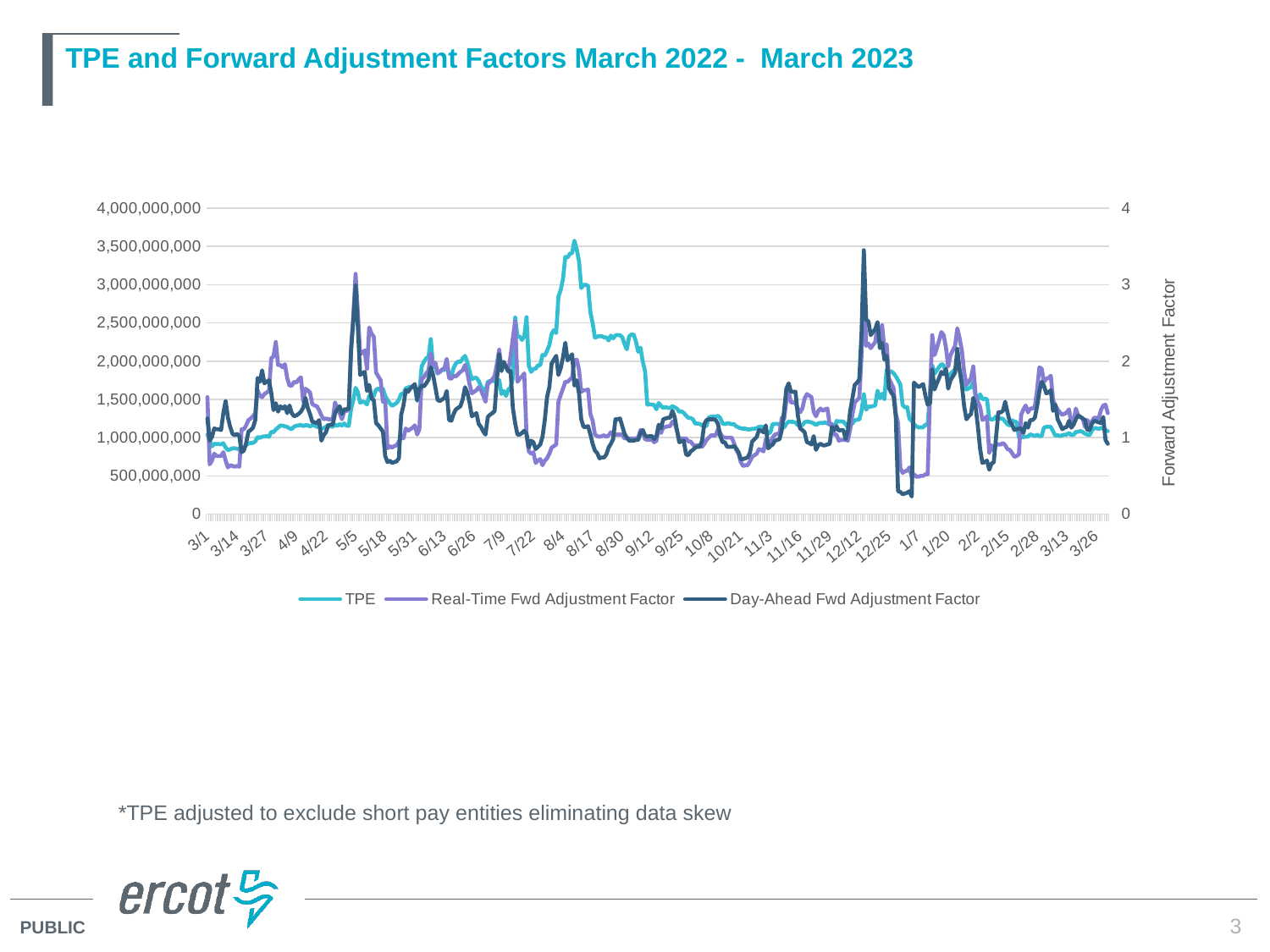
What is the label on the right-hand vertical axis? Forward Adjustment Factor Is the spike in the Day-Ahead Fwd Adjustment Factor around 12/12 greater or less than 3? greater Near which x-axis date does the Day-Ahead Fwd Adjustment Factor reach its highest value? 12/12 Does the TPE series rise or fall between 8/4 and 9/12? fall Is the TPE value around 9/25 greater or less than 1,500,000,000? less What kind of chart is shown on the slide? Line chart Near which x-axis date does the TPE series reach its highest value? 8/4 What is the title of the chart? TPE and Forward Adjustment Factors March 2022 - March 2023 Is the TPE value at 3/1 greater or less than 1,500,000,000? less How many series does the legend list? 3